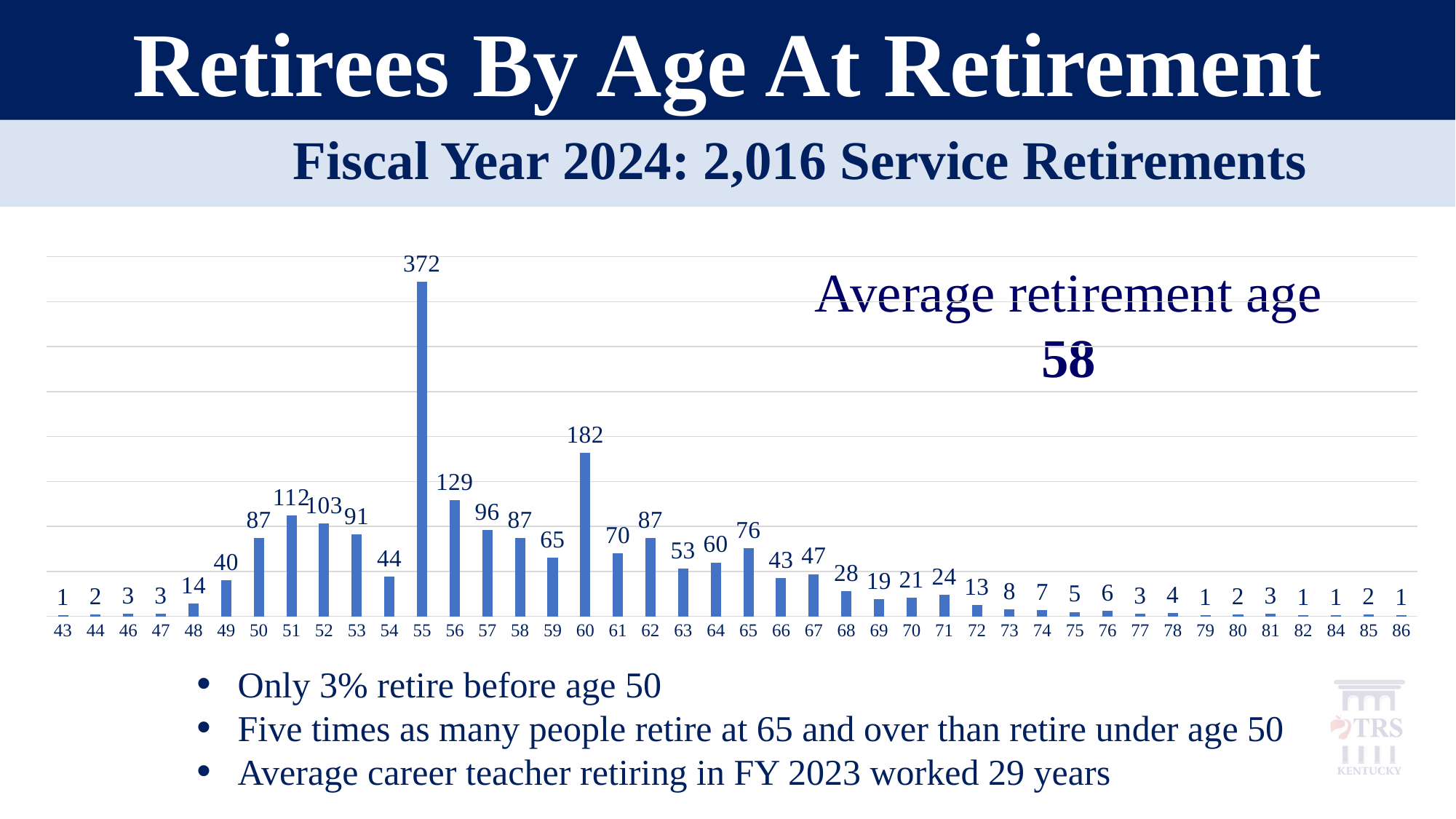
What average retirement age is stated on the chart? 58 What kind of chart is shown on the slide? Bar chart What is the number of retirees at age 60? 182 How many retirees retired at age 55? 372 How many retirees retired at age 65? 76 What is the difference between the number of retirees at age 55 and at age 60? 190 How many retirees retired at age 49? 40 Which age has more retirees, 51 or 52? 51 Which age has the highest number of retirees? 55 What is the difference between the number of retirees at age 56 and at age 57? 33 How many age categories are shown on the x axis? 42 How many retirees retired at age 68? 28